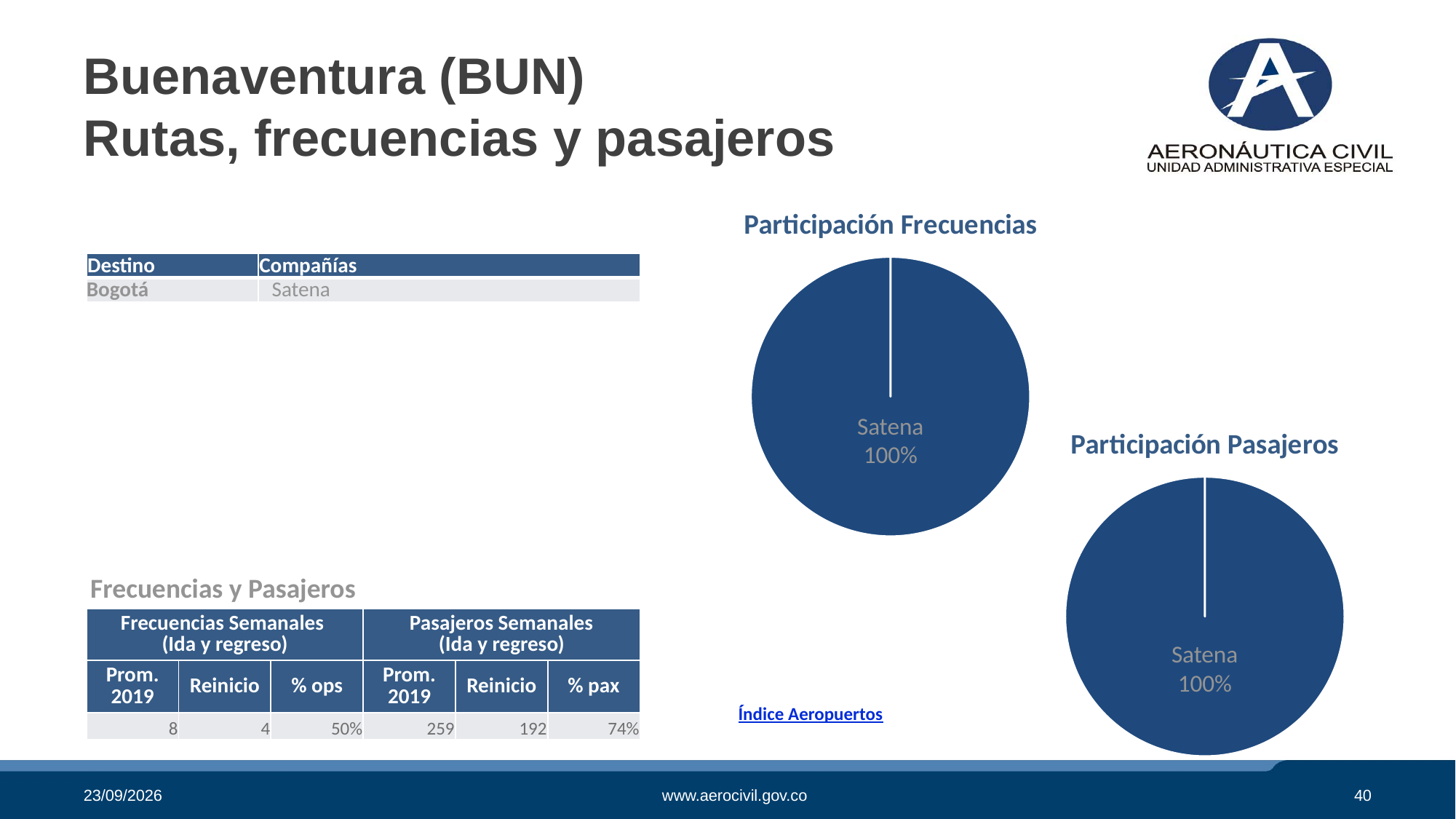
How many slices does the 'Participación Frecuencias' pie chart have? 1 Which company is labelled in the 'Participación Pasajeros' pie chart? Satena What kind of chart is 'Participación Frecuencias'? Pie chart In the 'Participación Pasajeros' chart, what share does Satena hold? 100% In the 'Participación Frecuencias' chart, what share does Satena hold? 100% Which company is labelled in the 'Participación Frecuencias' pie chart? Satena What kind of chart is 'Participación Pasajeros'? Pie chart How many slices does the 'Participación Pasajeros' pie chart have? 1 What is the title of the pie chart positioned at the lower right of the slide? Participación Pasajeros How many pie charts are shown on the slide? 2 What is the title of the pie chart positioned at the upper right of the slide? Participación Frecuencias